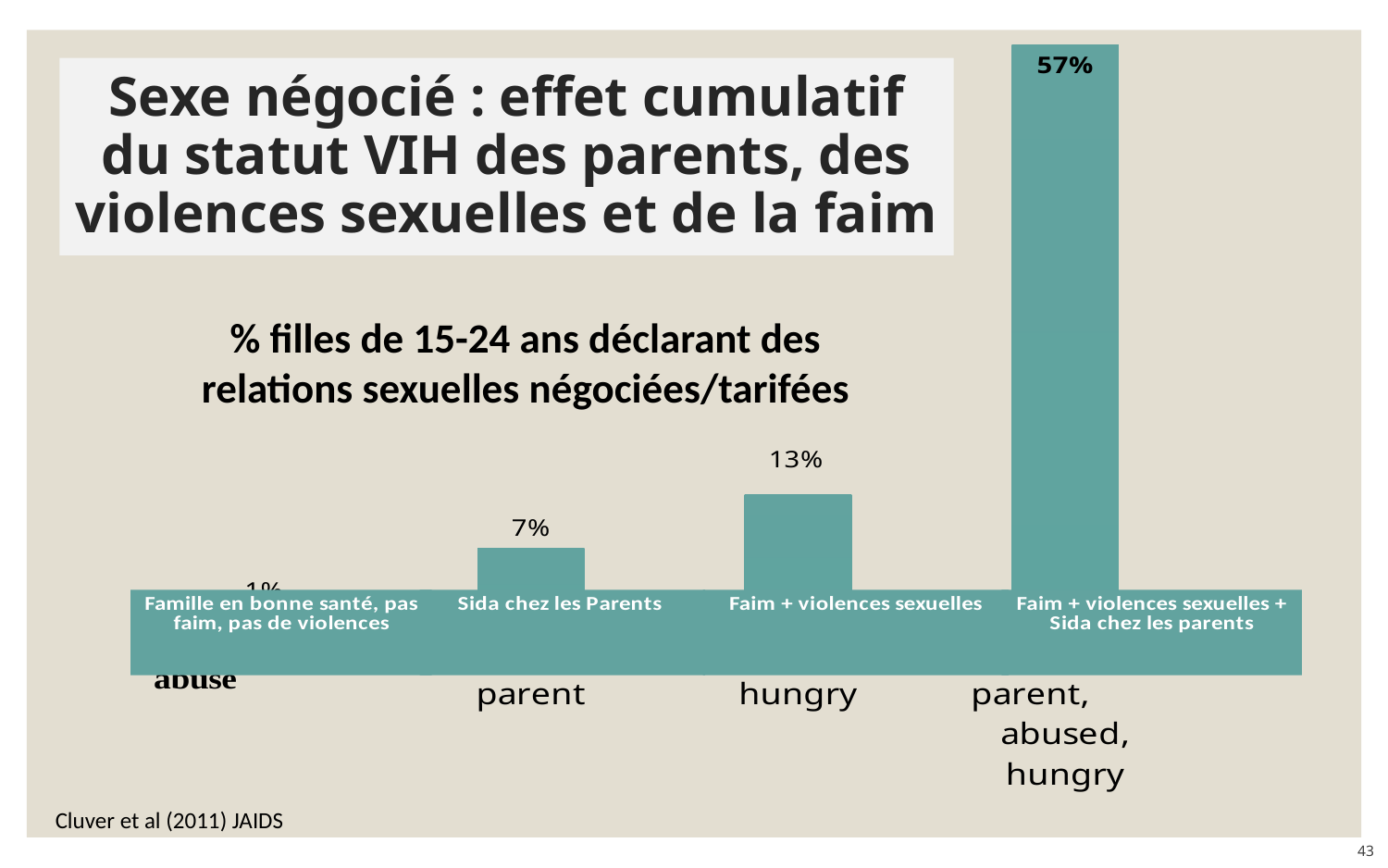
What is the value for 'Sida chez les Parents'? 7% How many categories are shown in the chart? 4 Which is larger, the value for 'Sida chez les Parents' or the value for 'Faim + violences sexuelles'? Faim + violences sexuelles What type of chart is shown on the slide? bar chart What is the value for 'Faim + violences sexuelles'? 13% What is the title of the chart? % filles de 15-24 ans déclarant des relations sexuelles négociées/tarifées Which category has the lowest value? Famille en bonne santé, pas faim, pas de violences Do the values rise or fall from left to right across the categories? rise Which category has the highest value? Faim + violences sexuelles + Sida chez les parents What is the value for 'Faim + violences sexuelles + Sida chez les parents'? 57% What is the difference between the values for 'Faim + violences sexuelles' and 'Sida chez les Parents'? 6% What is the difference between the values for 'Faim + violences sexuelles + Sida chez les parents' and 'Faim + violences sexuelles'? 44%